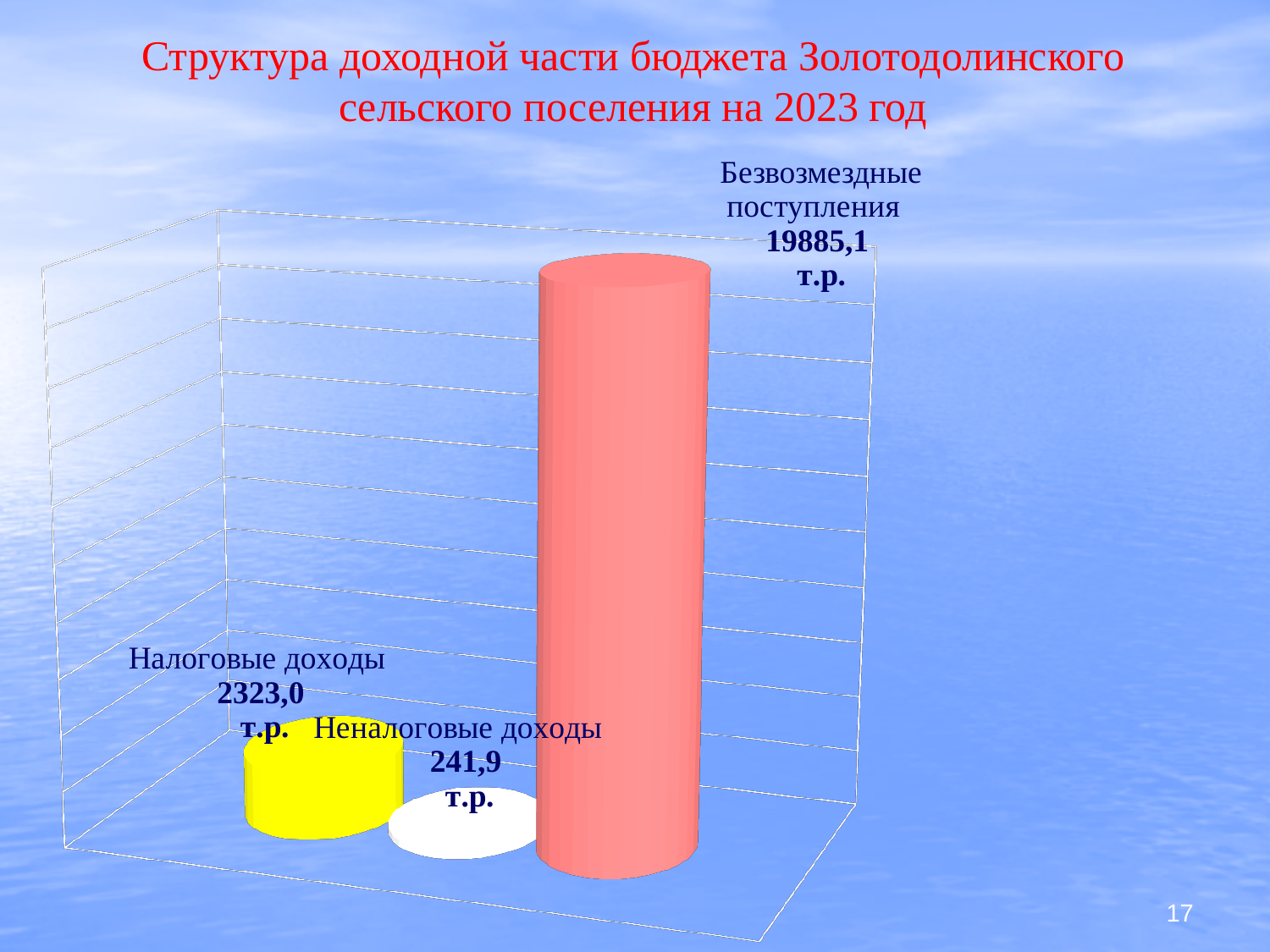
What is the difference between Безвозмездные поступления and Налоговые доходы? 17562,1 т.р. What is the title of the slide? Структура доходной части бюджета Золотодолинского сельского поселения на 2023 год How many categories are shown in the chart? 3 Which category has the lowest value? Неналоговые доходы Which category has the highest value? Безвозмездные поступления What is the value shown for Неналоговые доходы? 241,9 т.р. What is the value shown for Безвозмездные поступления? 19885,1 т.р. What is the value shown for Налоговые доходы? 2323,0 т.р. Which is larger, Налоговые доходы or Неналоговые доходы? Налоговые доходы What kind of chart is shown on the slide? Bar chart What is the difference between Налоговые доходы and Неналоговые доходы? 2081,1 т.р. What colour is the bar for Безвозмездные поступления? Red (pink)